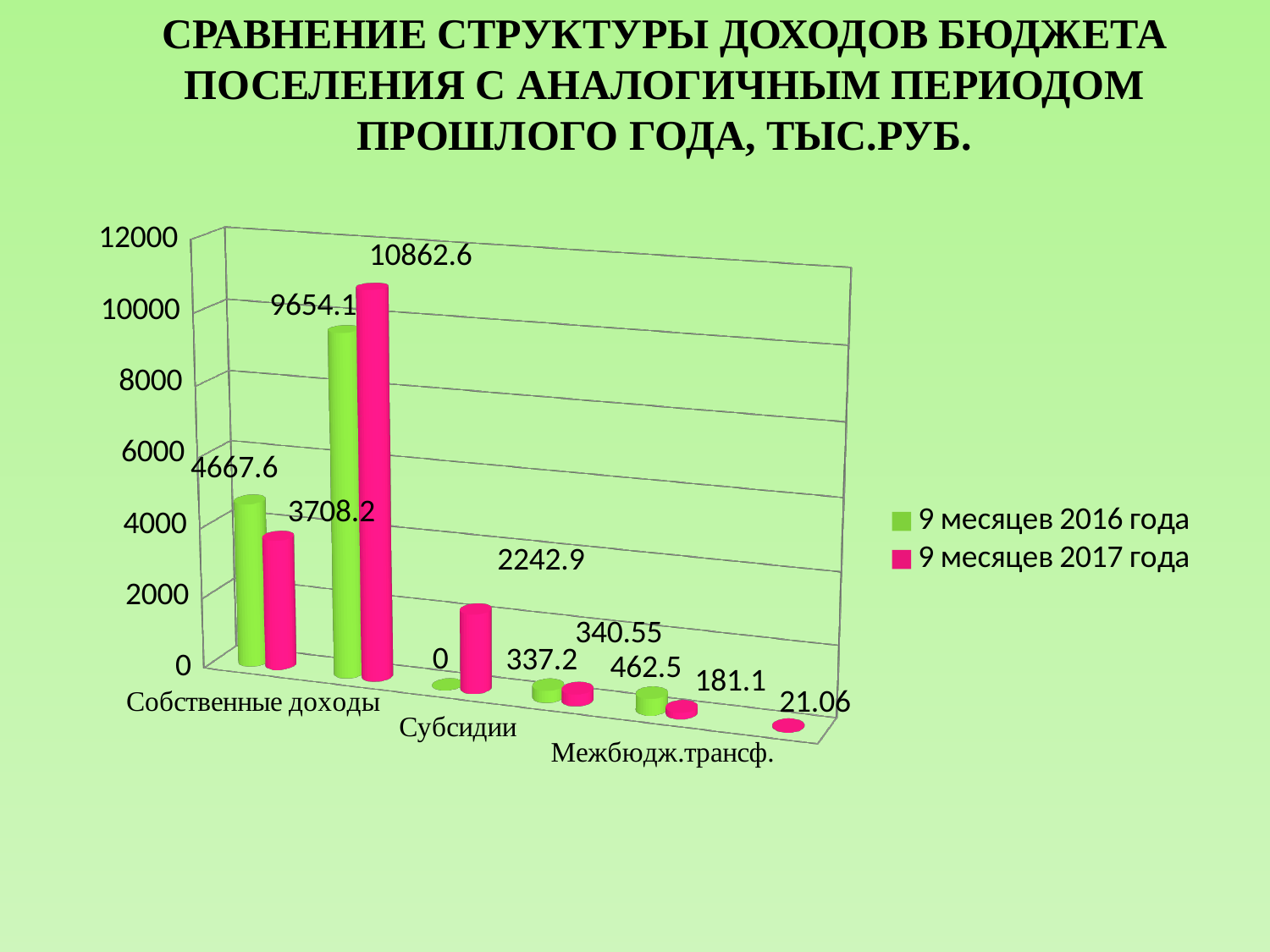
What is the value for Субсидии in the 9 месяцев 2016 года series? 0 What is the value for Собственные доходы in the 9 месяцев 2016 года series? 4667.6 What is the value for Межбюдж.трансф. in the 9 месяцев 2017 года series? 181.1 For Межбюдж.трансф., which series has the larger value, 9 месяцев 2016 года or 9 месяцев 2017 года? 9 месяцев 2016 года What kind of chart is shown on the slide? bar chart What is the highest value labelled on the chart? 10862.6 By how much does the 9 месяцев 2016 года value for Собственные доходы exceed the 9 месяцев 2017 года value? 959.4 What is the value for Субсидии in the 9 месяцев 2017 года series? 2242.9 What is the value for Межбюдж.трансф. in the 9 месяцев 2016 года series? 462.5 How many series does the legend list? 2 What is the value for Собственные доходы in the 9 месяцев 2017 года series? 3708.2 What is the difference between the 2016 and 2017 values for Межбюдж.трансф.? 281.4